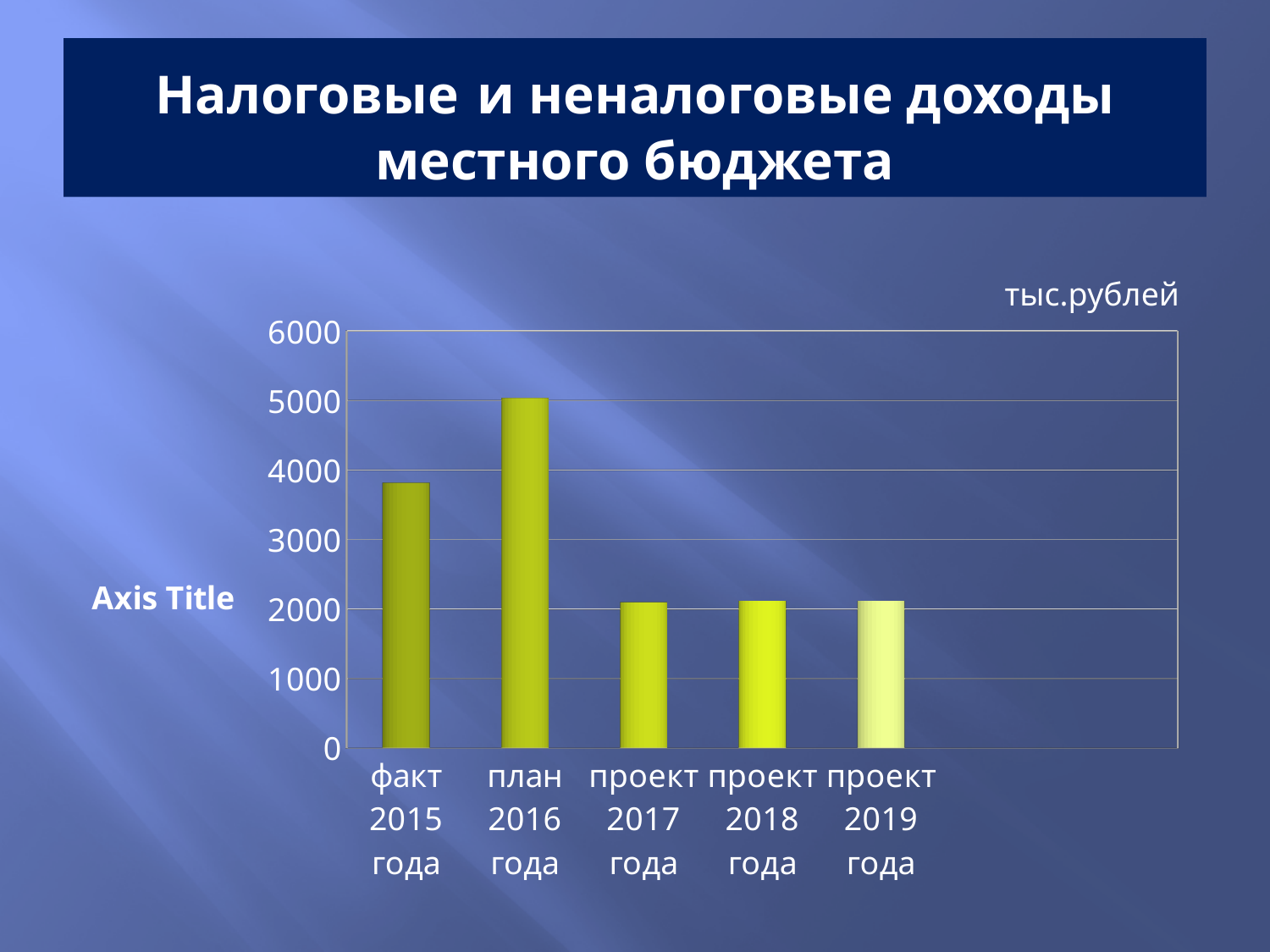
Which is larger, the value for факт 2015 года or the value for план 2016 года? план 2016 года Is the value for проект 2017 года greater or less than 3000? less Which is larger, the value for факт 2015 года or the value for проект 2018 года? факт 2015 года Is the value for проект 2019 года greater or less than 2000? greater Do the values rise or fall from план 2016 года to проект 2017 года? fall Is the value for факт 2015 года greater or less than 3000? greater How many categories are shown on the x axis of the chart? 5 What unit is indicated above the chart? тыс.рублей What kind of chart is shown on the slide? bar chart Which category has the highest value in the chart? план 2016 года